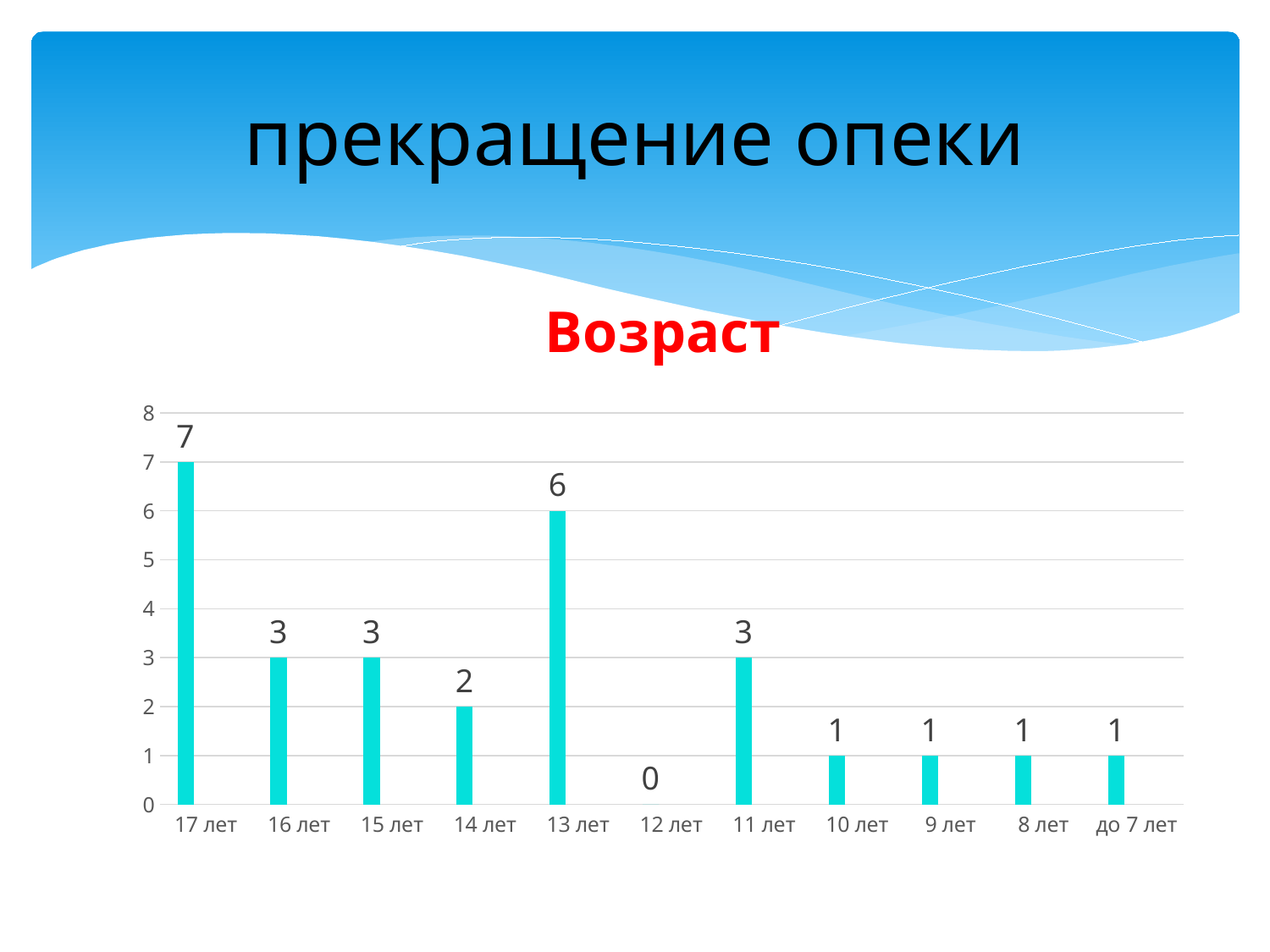
Which category has the lowest value? 12 лет Which is larger, the value for 11 лет or the value for 10 лет? 11 лет What is the title of the chart? Возраст What is the difference between the values for 16 лет and 14 лет? 1 What is the value for до 7 лет? 1 What kind of chart is shown on the slide? bar chart How many categories are shown on the x axis? 11 Which category has the highest value? 17 лет What is the value for 13 лет? 6 What is the difference between the values for 17 лет and 13 лет? 1 What is the value for 12 лет? 0 What is the value for 17 лет? 7